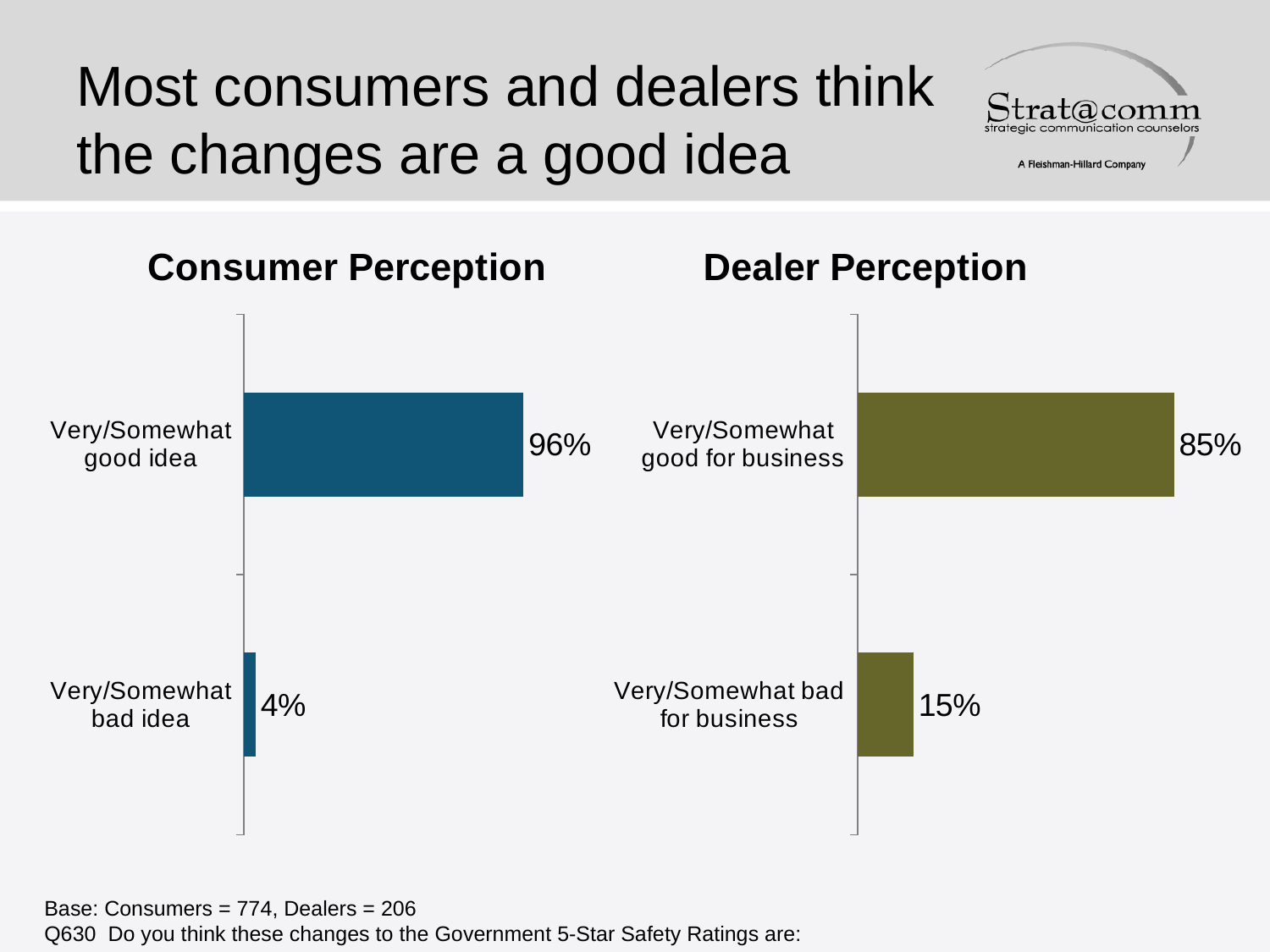
What is the title of the chart on the right side of the slide? Dealer Perception What kind of chart is the Consumer Perception chart? Bar chart In the Dealer Perception chart, what is the value for Very/Somewhat bad for business? 15% In the Consumer Perception chart, what is the value for Very/Somewhat bad idea? 4% In the Dealer Perception chart, what is the difference between Very/Somewhat good for business and Very/Somewhat bad for business? 70% In the Consumer Perception chart, which category has the highest value? Very/Somewhat good idea In the Dealer Perception chart, what is the value for Very/Somewhat good for business? 85% How many categories does the Dealer Perception chart show? 2 In the Dealer Perception chart, which category has the lowest value? Very/Somewhat bad for business Which is larger: the Consumer Perception value for Very/Somewhat good idea or the Dealer Perception value for Very/Somewhat good for business? Consumer Perception Very/Somewhat good idea In the Consumer Perception chart, what is the value for Very/Somewhat good idea? 96% In the Consumer Perception chart, what is the difference between Very/Somewhat good idea and Very/Somewhat bad idea? 92%